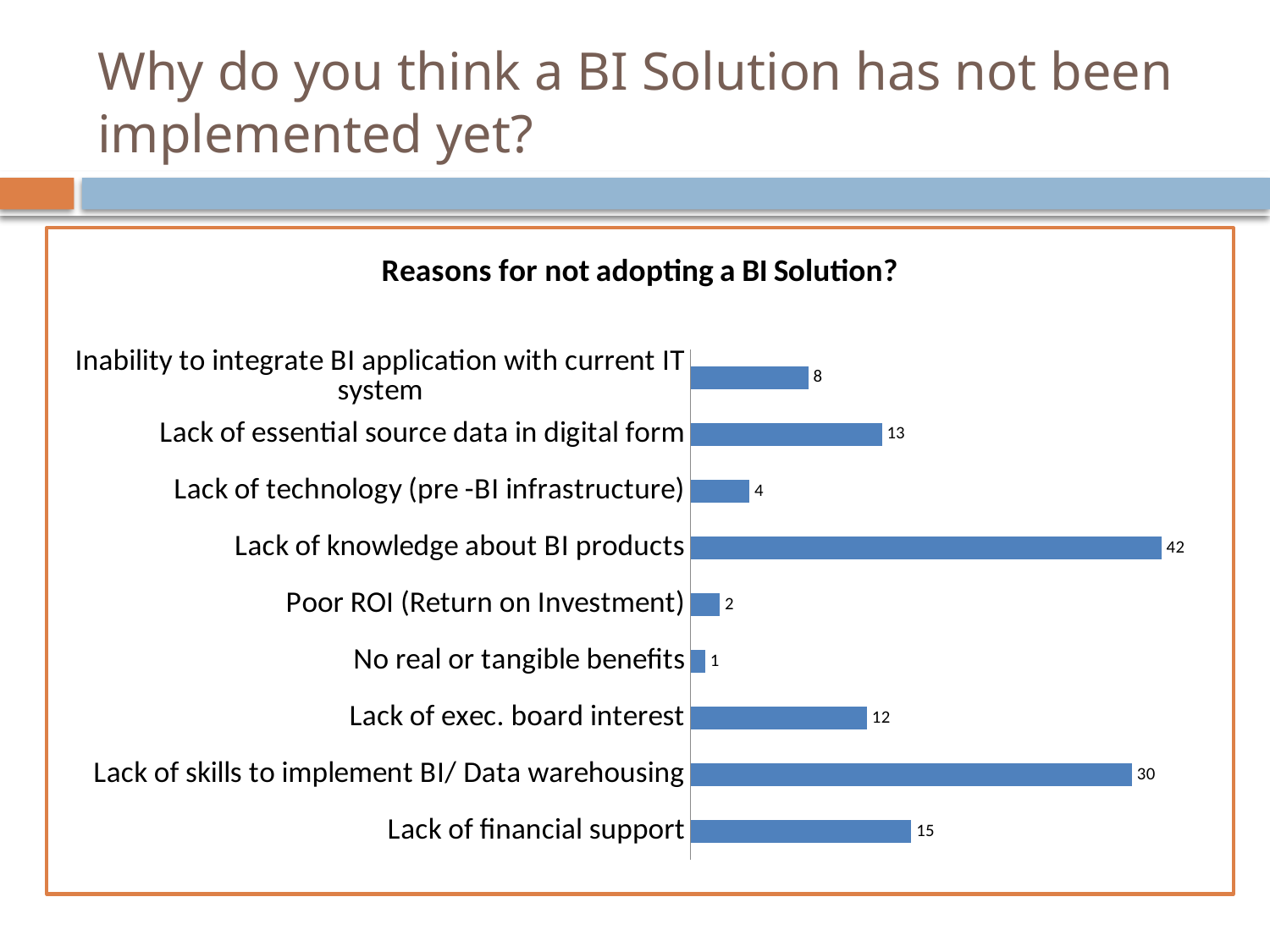
What is the difference between 'Lack of financial support' and 'Lack of exec. board interest'? 3 Which is larger: 'Lack of essential source data in digital form' or 'Inability to integrate BI application with current IT system'? Lack of essential source data in digital form Which category has the highest value? Lack of knowledge about BI products What is the value for 'Lack of knowledge about BI products'? 42 What kind of chart is shown on the slide? Bar chart What is the difference between 'Lack of knowledge about BI products' and 'Lack of skills to implement BI/ Data warehousing'? 12 Which is larger: 'Poor ROI (Return on Investment)' or 'Lack of technology (pre -BI infrastructure)'? Lack of technology (pre -BI infrastructure) What is the value for 'Lack of technology (pre -BI infrastructure)'? 4 What is the value for 'Lack of financial support'? 15 Which category has the lowest value? No real or tangible benefits How many categories are shown in the chart? 9 What is the title of the chart? Reasons for not adopting a BI Solution?